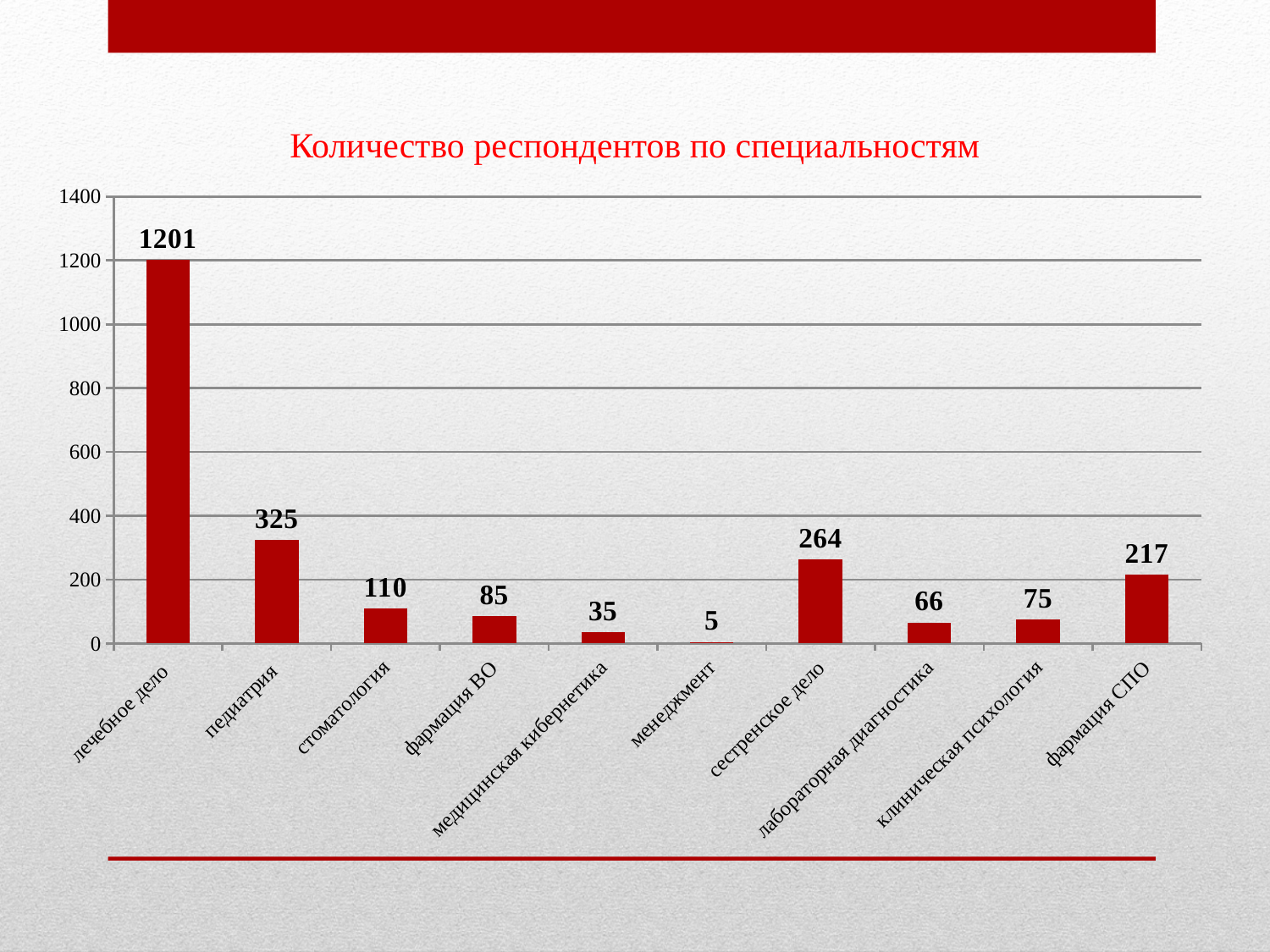
What is the value for фармация СПО? 217 What is the title of the chart? Количество респондентов по специальностям What is the value for сестринское дело? 264 Is the value for педиатрия greater or less than 400? less Which specialty has the lowest number of respondents? менеджмент What is the difference between сестринское дело and фармация СПО? 47 What kind of chart is this? bar chart Which specialty has the highest number of respondents? лечебное дело What is the value for лечебное дело? 1201 Which is larger, лабораторная диагностика or клиническая психология? клиническая психология How many specialties are shown on the chart? 10 What is the difference between педиатрия and стоматология? 215